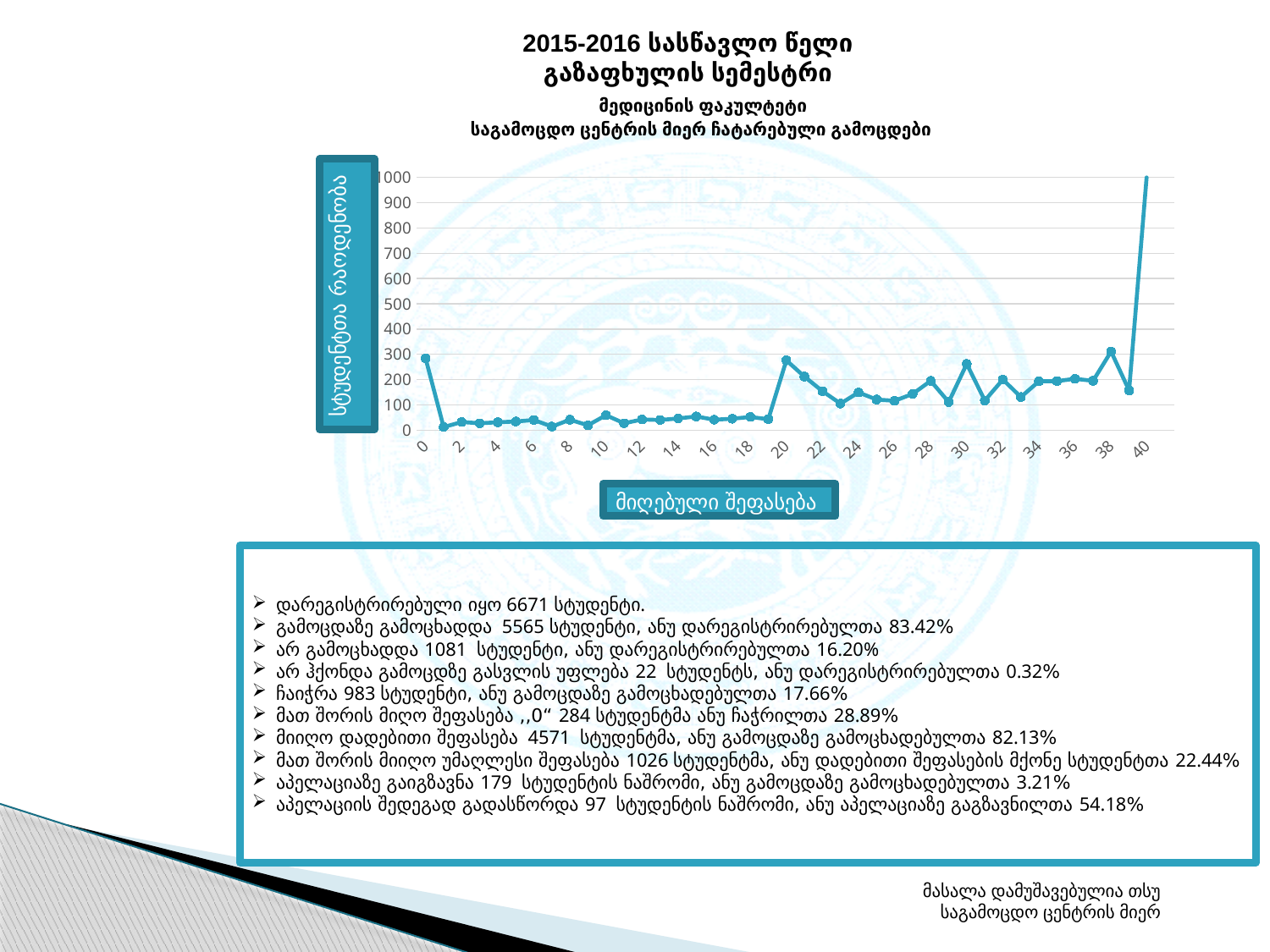
Is the value at score 40 greater or less than 900? greater Which has the larger value, score 38 or score 39? score 38 Does the line rise or fall between score 0 and score 1? fall Is the value at score 30 greater or less than 200? greater At which x-axis value (score) does the line reach its highest point? 40 Is the value at score 20 greater or less than 200? greater What is the highest tick label on the y axis? 1000 What is the title of the y axis? სტუდენტთა რაოდენობა Which has the larger value, score 20 or score 10? score 20 What kind of chart is shown on the slide? line chart